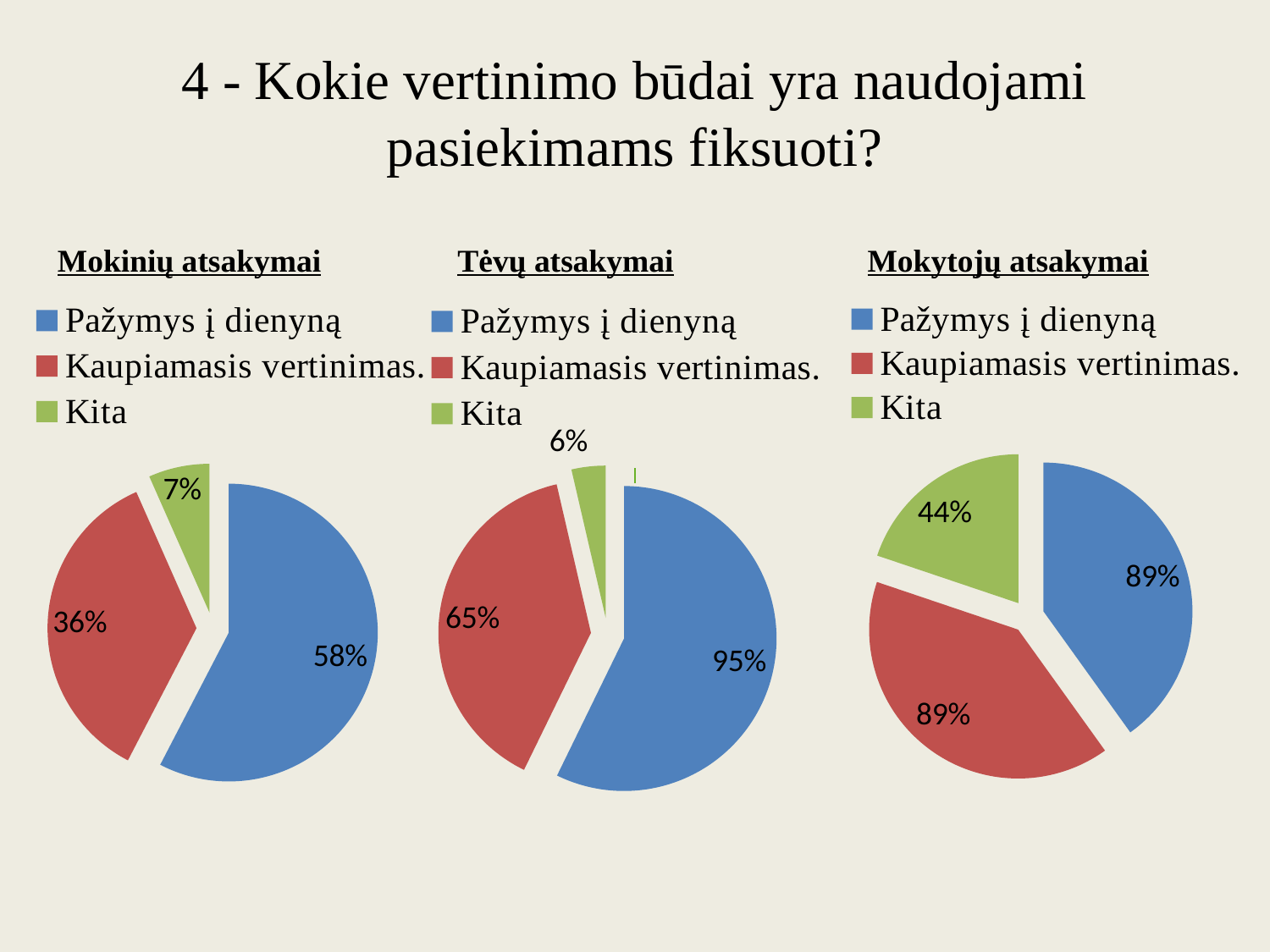
In the Mokinių atsakymai chart, which category has the smallest slice? Kita In the Tėvų atsakymai chart, which category has the largest slice? Pažymys į dienyną In the Tėvų atsakymai chart, what percentage is shown for Kaupiamasis vertinimas? 65% In the Mokinių atsakymai chart, what percentage is shown for Pažymys į dienyną? 58% In the Mokytojų atsakymai chart, which category has the smallest slice? Kita How many slices does the Mokinių atsakymai pie chart have? 3 In the Mokinių atsakymai chart, what is the difference between the Pažymys į dienyną and Kaupiamasis vertinimas percentages? 22% In the Mokinių atsakymai chart, what percentage is shown for Kita? 7% In the Tėvų atsakymai chart, which is larger: Pažymys į dienyną or Kaupiamasis vertinimas? Pažymys į dienyną How many pie charts are shown on the slide? 3 What type of chart is used for Tėvų atsakymai? Pie chart In the Mokytojų atsakymai chart, what percentage is shown for Kita? 44%